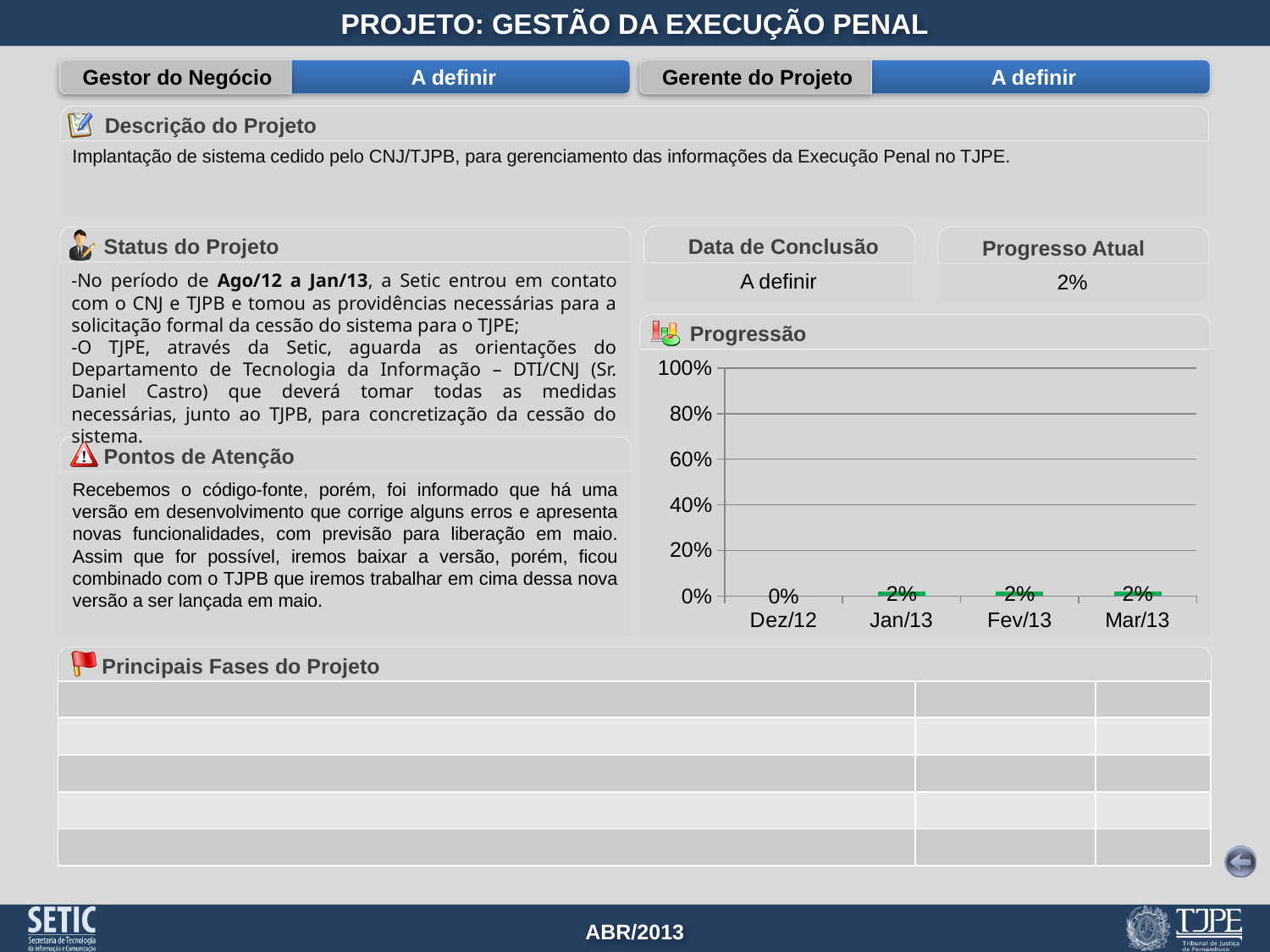
What is the value for Jan/13 in the Progressão chart? 2% What is the value for Dez/12 in the Progressão chart? 0% What is the value for Mar/13 in the Progressão chart? 2% What is the difference between the values for Jan/13 and Dez/12 in the Progressão chart? 2% Do the values in the Progressão chart rise or fall from Dez/12 to Jan/13? rise What is the title of the chart on the slide? Progressão Which is larger in the Progressão chart, the value for Fev/13 or the value for Dez/12? Fev/13 Is the value for Mar/13 in the Progressão chart greater or less than 20%? less Which category has the lowest value in the Progressão chart? Dez/12 What kind of chart is the Progressão chart? bar chart What is the value for Fev/13 in the Progressão chart? 2% How many categories are shown on the x axis of the Progressão chart? 4